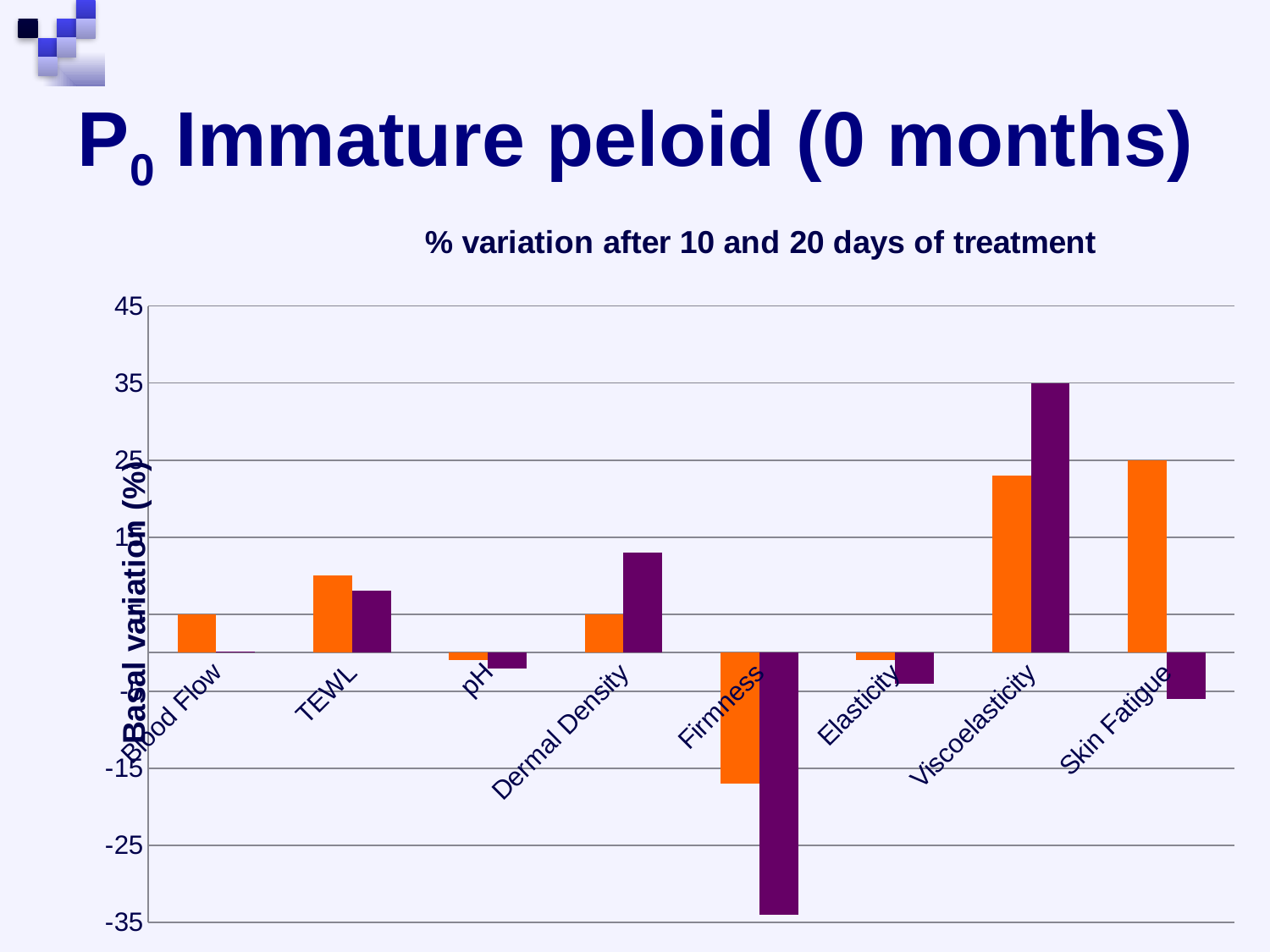
What kind of chart is shown on the slide? bar chart What is the label of the vertical axis? Basal variation (%) Which is larger, the purple bar for Dermal Density or the purple bar for TEWL? Dermal Density What is the title of the chart? % variation after 10 and 20 days of treatment Is the purple bar for Viscoelasticity greater or less than 25? greater Which category has the lowest (most negative) bar in the chart? Firmness Which is larger, the orange bar for TEWL or the orange bar for Dermal Density? TEWL Is the orange bar for Skin Fatigue greater or less than 15? greater Is the purple bar for Firmness greater or less than -25? less How many categories are shown on the x axis of the chart? 8 Which category has the tallest bar in the chart? Viscoelasticity